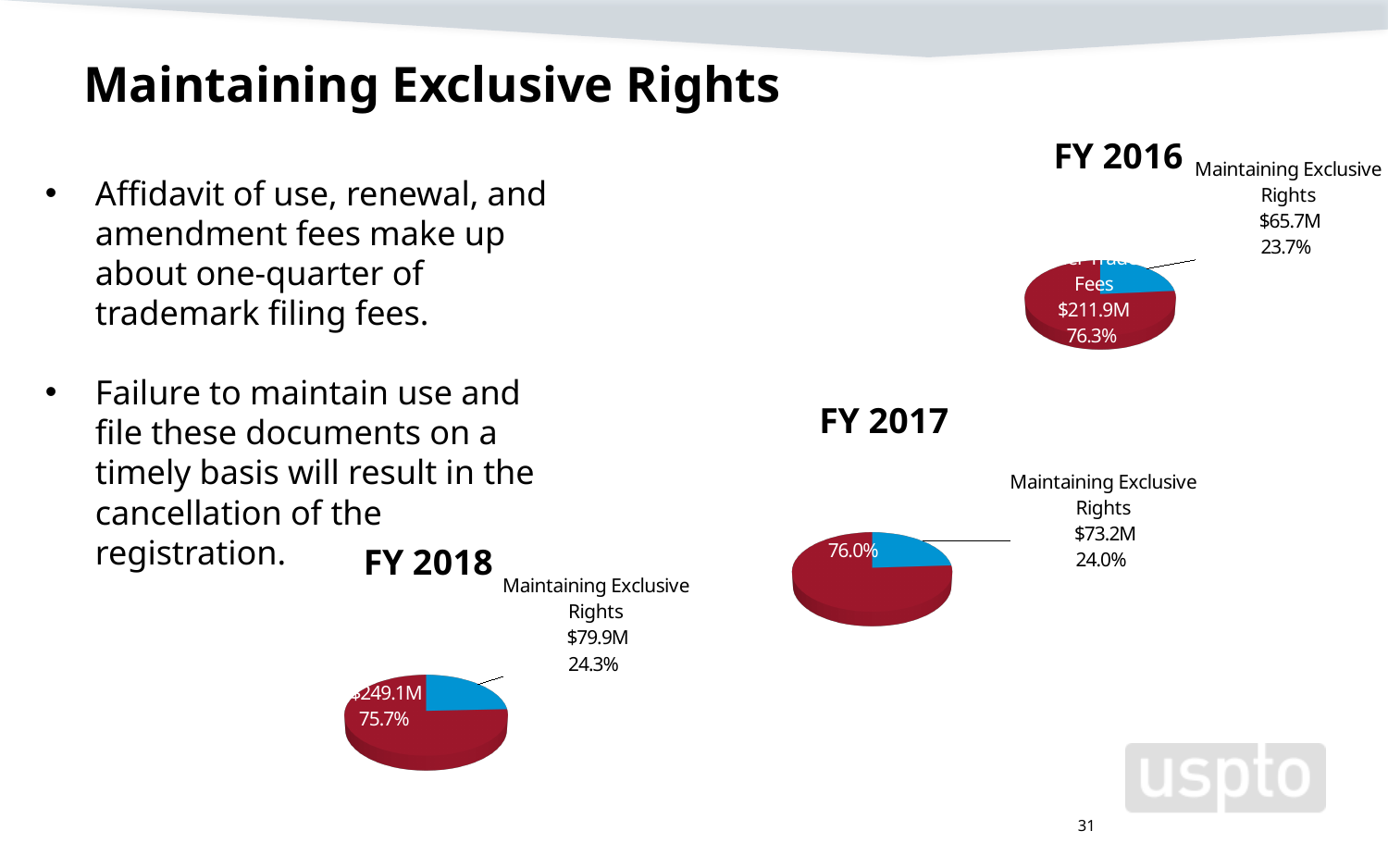
On the FY 2016 chart, what percentage share does Maintaining Exclusive Rights have? 23.7% On the FY 2016 chart, what is the value shown for Maintaining Exclusive Rights? $65.7M On the FY 2016 chart, what is the value shown for the larger (red) slice? $211.9M What kind of chart is used for FY 2018? Pie chart On the FY 2017 chart, what percentage share does Maintaining Exclusive Rights have? 24.0% How many pie charts are shown on the slide? 3 On the FY 2017 chart, what is the value shown for Maintaining Exclusive Rights? $73.2M On the FY 2018 chart, what is the value shown for Maintaining Exclusive Rights? $79.9M On the FY 2016 chart, what percentage share does the larger (red) slice have? 76.3%